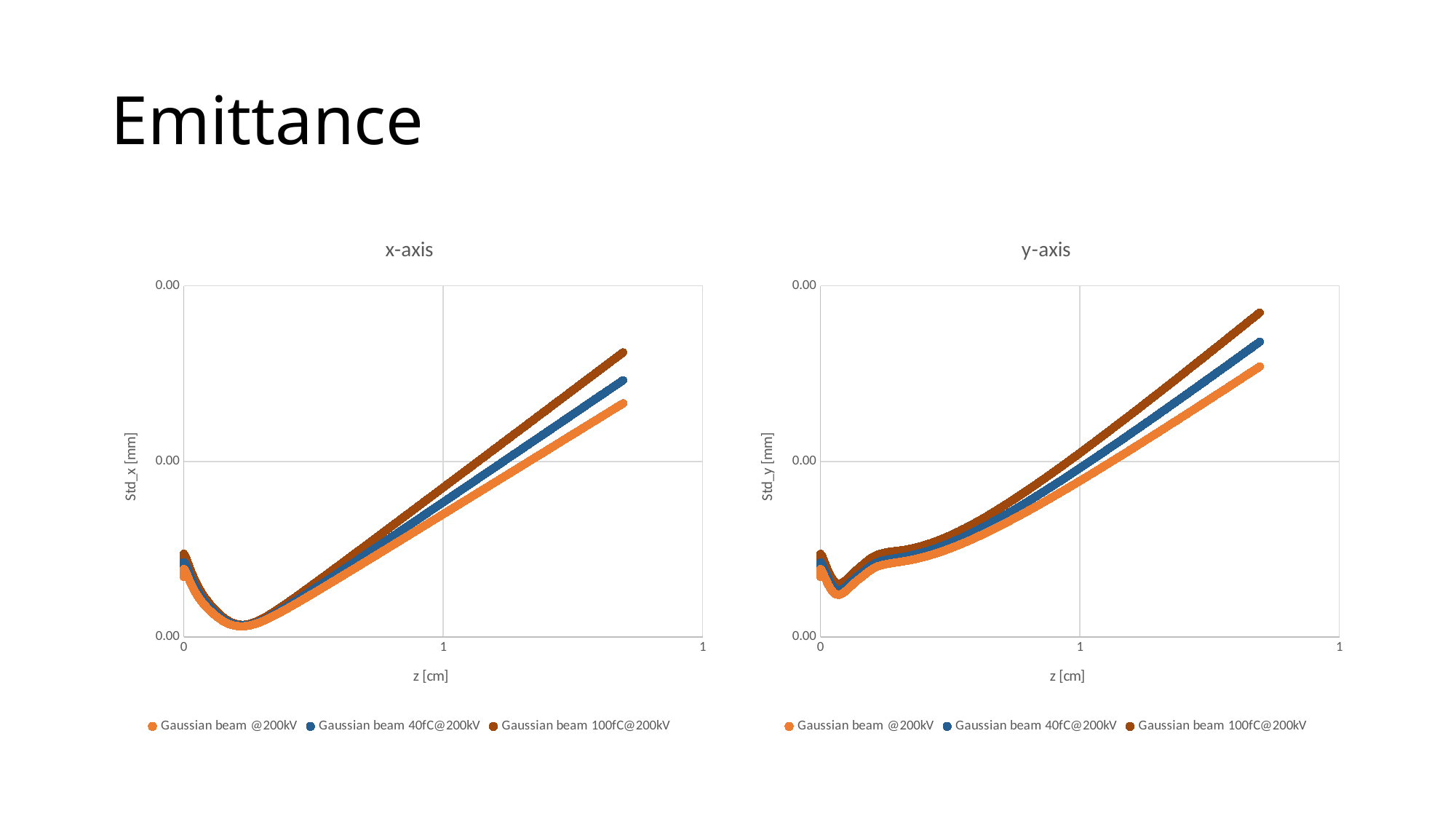
In the chart titled "x-axis", which series reaches the highest value at the right end of the z axis? Gaussian beam 100fC@200kV What kind of chart is the chart titled "x-axis"? line chart How many series does the legend of the chart titled "x-axis" list? 3 How many series does the legend of the chart titled "y-axis" list? 3 What is the label of the vertical axis on the chart titled "y-axis"? Std_y [mm] What is the label of the horizontal axis on the chart titled "x-axis"? z [cm] In the chart titled "y-axis", do the series values rise or fall over the right half of the z axis? rise In the chart titled "x-axis", do the series values rise or fall over the right half of the z axis? rise In the chart titled "x-axis", at the right end of the z axis, is the value for Gaussian beam 100fC@200kV larger or smaller than the value for Gaussian beam @200kV? larger In the chart titled "y-axis", at the right end of the z axis, which is larger: Gaussian beam 40fC@200kV or Gaussian beam @200kV? Gaussian beam 40fC@200kV In the chart titled "y-axis", which series has the lowest value at the right end of the z axis? Gaussian beam @200kV